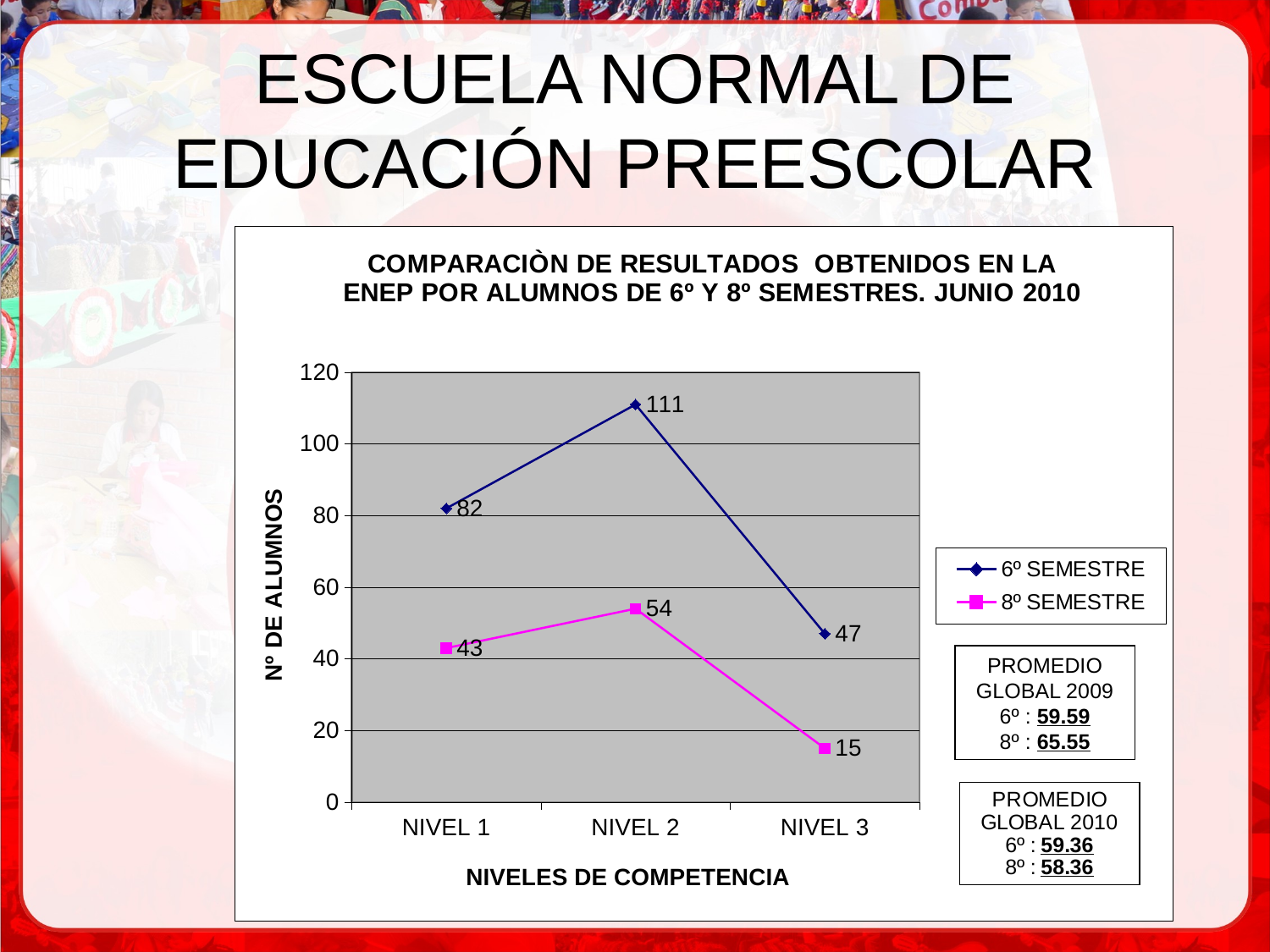
What is the value for 6º SEMESTRE at NIVEL 1? 82 What is the value for 6º SEMESTRE at NIVEL 2? 111 What is the value for 8º SEMESTRE at NIVEL 3? 15 Which series has the larger value at NIVEL 3, 6º SEMESTRE or 8º SEMESTRE? 6º SEMESTRE At which competence level does the 8º SEMESTRE series have its lowest value? NIVEL 3 How many competence levels are shown on the x axis? 3 What kind of chart is shown on the slide? Line chart How many series does the legend list? 2 At which competence level does the 6º SEMESTRE series reach its highest value? NIVEL 2 What is the difference between the 6º SEMESTRE and 8º SEMESTRE values at NIVEL 2? 57 What is the label of the y axis? Nº DE ALUMNOS What is the value for 8º SEMESTRE at NIVEL 1? 43